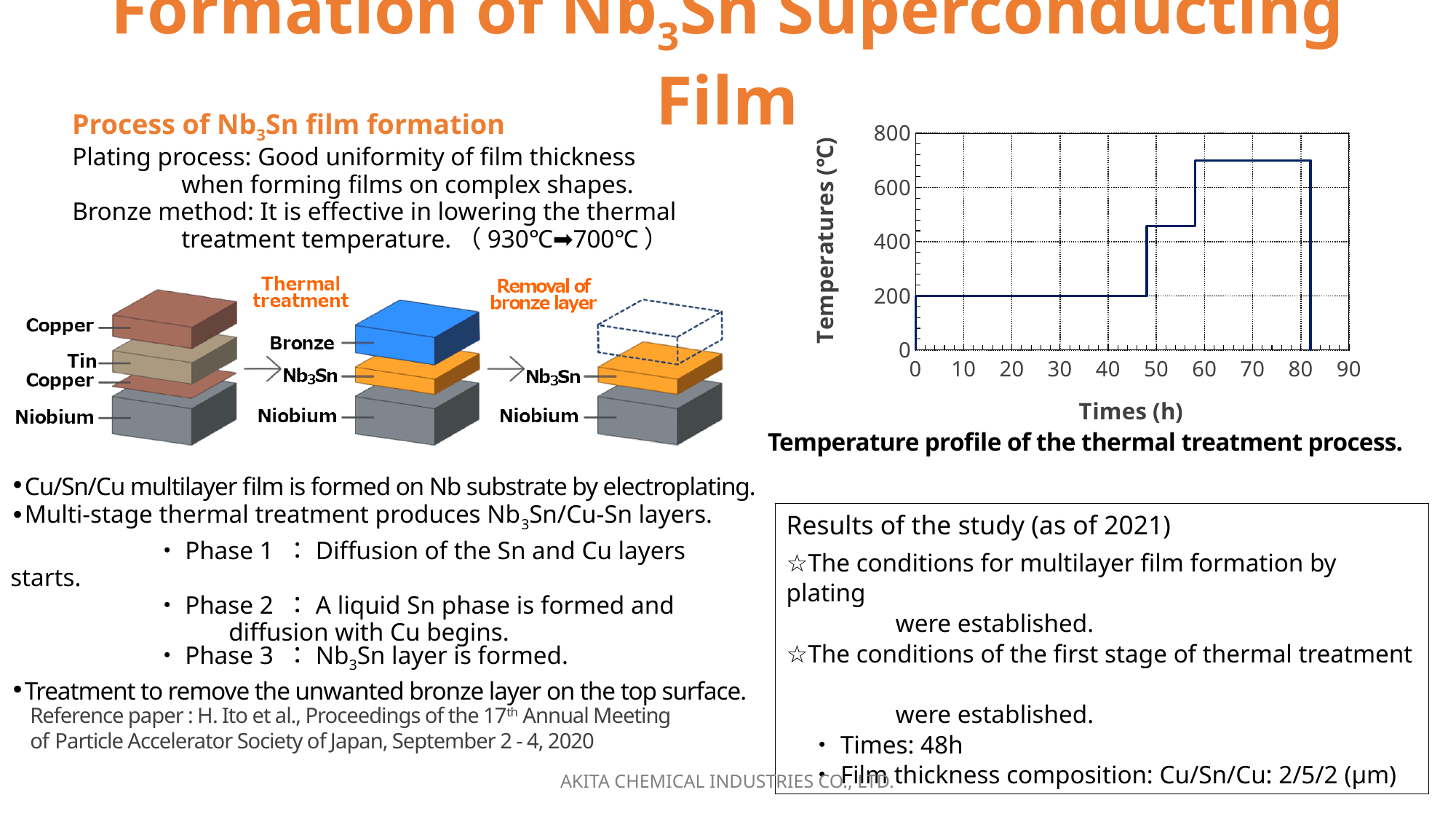
In the temperature profile chart, what temperature is held during the first stage, from 0 h to about 48 h? 200 In the temperature profile chart, which is higher: the temperature at 70 h or the temperature at 20 h? 70 h In the temperature profile chart, is the temperature of the middle plateau (around 50 h) greater or less than 400? greater In the temperature profile chart, is the temperature at 30 h greater or less than 400? less How many temperature plateaus (holding stages) does the temperature profile chart show before the drop to 0? 3 What is the highest value shown on the y axis of the temperature profile chart? 800 In the temperature profile chart, is the temperature of the highest plateau greater or less than 600? greater What is the label of the x axis of the temperature profile chart? Times (h) What kind of chart is shown on the right of the slide? line chart What is the label of the y axis of the temperature profile chart? Temperatures (°C) How does the temperature change along the time axis in the temperature profile chart before the final drop? rises in steps